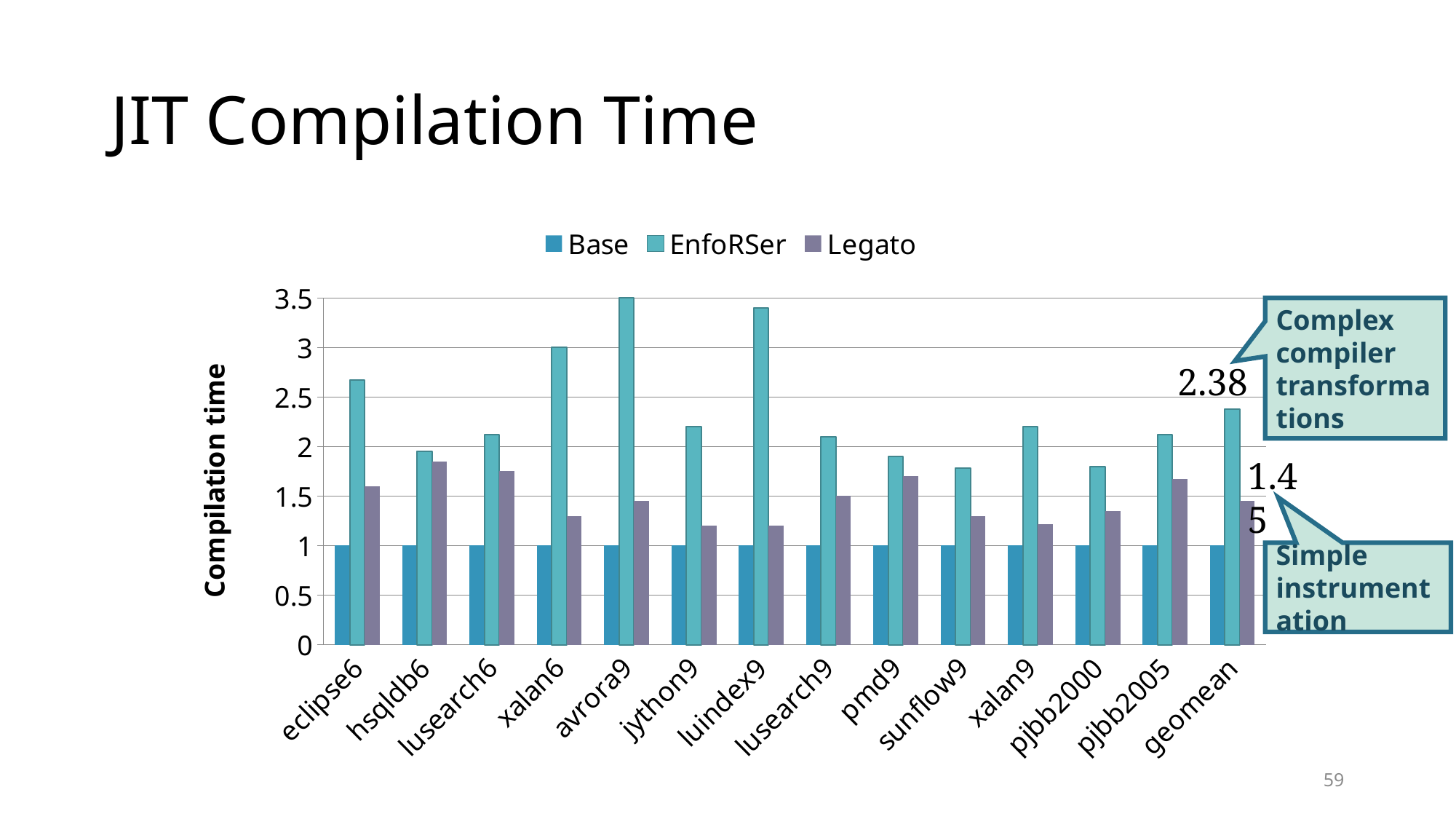
Is the EnfoRSer value for xalan6 greater or less than 2.5? greater Which category has the highest EnfoRSer bar? avrora9 What is the title of the y axis? Compilation time What is the EnfoRSer value for geomean? 2.38 Is the Legato value for xalan6 greater or less than 1.5? less What kind of chart is shown on the slide? bar chart How many series does the legend list? 3 What is the Legato value for geomean? 1.45 For avrora9, which is larger: the EnfoRSer value or the Legato value? EnfoRSer What is the Base value for eclipse6? 1 How many categories are shown on the x axis? 14 What is the difference between the EnfoRSer and Legato values for geomean? 0.93